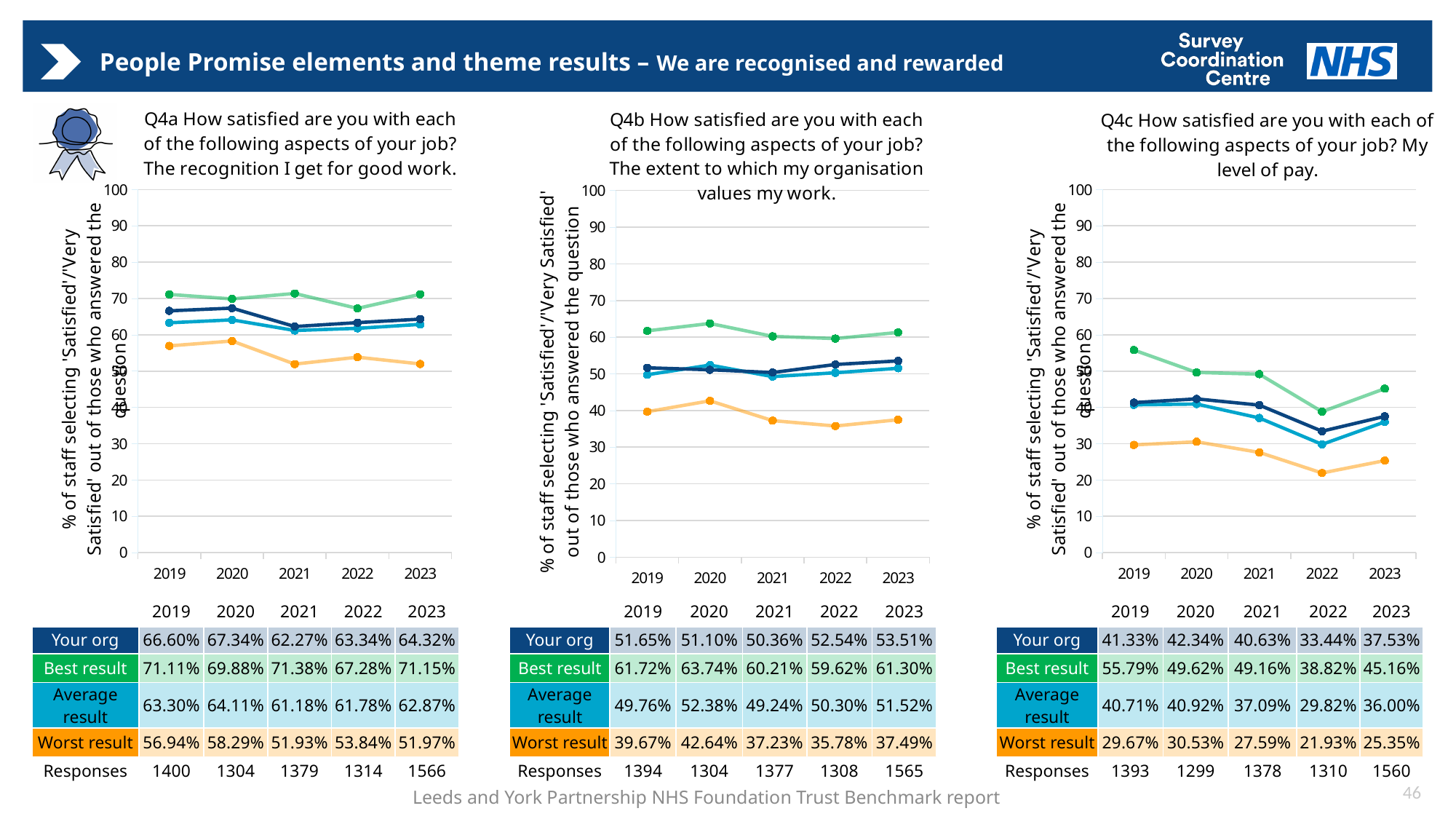
What type of chart is used for Q4c (My level of pay)? Line chart In the Q4a chart (The recognition I get for good work), what is the Your org value for 2023? 64.32% How many years are plotted on the x axis of the Q4b chart (The extent to which my organisation values my work)? 5 In the Q4c chart (My level of pay), does the Your org line rise or fall from 2021 to 2022? Fall In the Q4b chart (The extent to which my organisation values my work), what is the difference between the Best result and Your org values in 2020? 12.64% In the Q4c chart (My level of pay), what is the Average result value for 2021? 37.09% In the Q4b chart (The extent to which my organisation values my work), what is the Worst result value for 2022? 35.78% In the Q4c chart (My level of pay), in which year is the Your org value lowest? 2022 In the Q4a chart (The recognition I get for good work), is the Worst result value for 2021 greater or less than 60? less In the Q4c chart (My level of pay), which is larger: the Your org value in 2019 or in 2023? 2019 In the Q4a chart (The recognition I get for good work), how many responses were recorded in 2023? 1566 In the Q4a chart (The recognition I get for good work), in which year is the Best result value highest? 2021